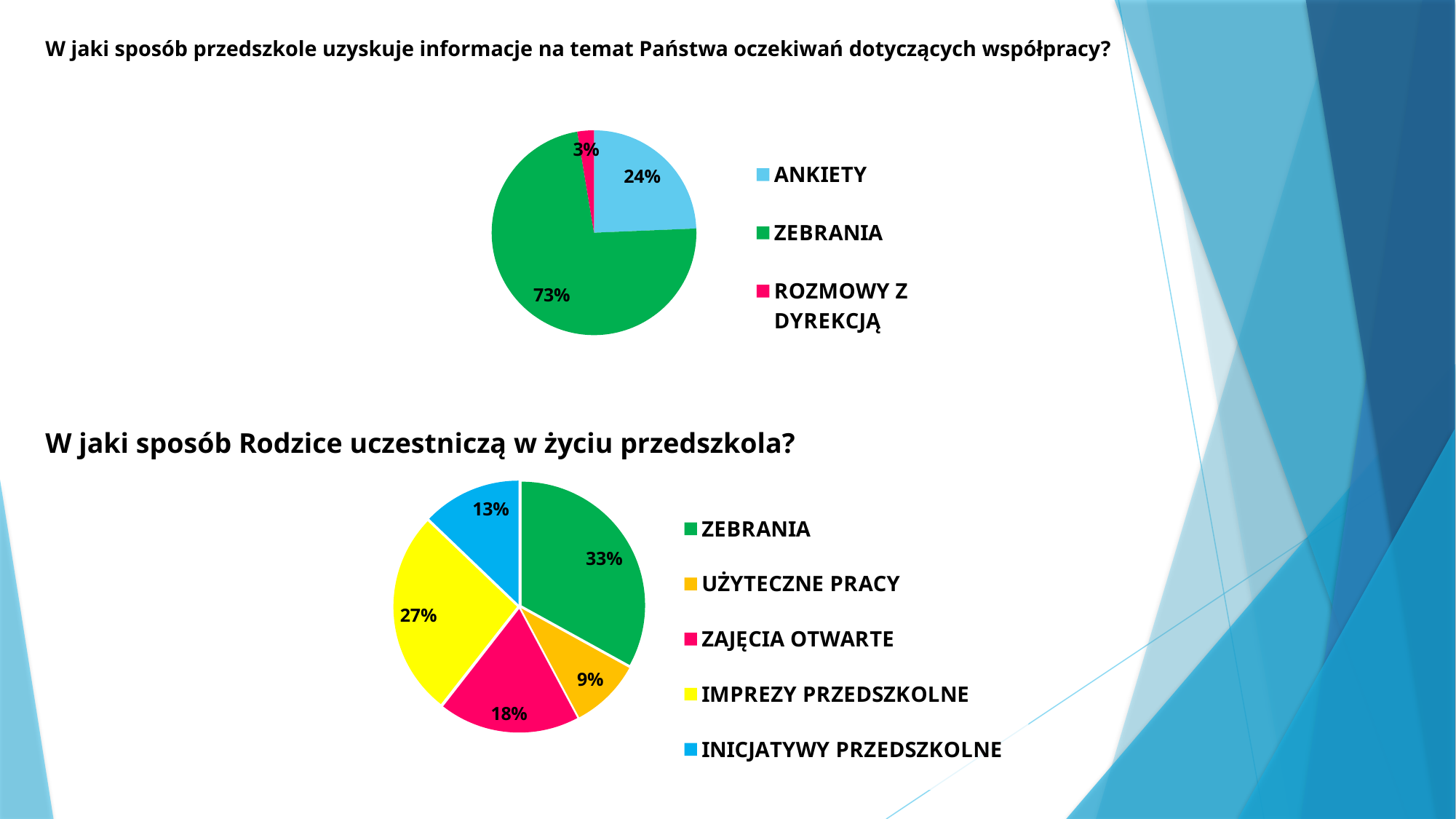
In the bottom pie chart, what share is labelled for IMPREZY PRZEDSZKOLNE? 27% In the bottom pie chart, which category has the largest slice? ZEBRANIA What type of chart is the bottom chart? Pie chart In the top pie chart, what share is labelled for ROZMOWY Z DYREKCJĄ? 3% In the bottom pie chart, what share is labelled for UŻYTECZNE PRACY? 9% In the top pie chart, how many slices are there? 3 In the top pie chart, which category has the smallest slice? ROZMOWY Z DYREKCJĄ In the bottom pie chart, how many categories does the legend list? 5 In the bottom pie chart, which is larger: INICJATYWY PRZEDSZKOLNE or ZAJĘCIA OTWARTE? ZAJĘCIA OTWARTE In the top pie chart, what share is labelled for ANKIETY? 24% In the bottom pie chart, what is the difference between the ZEBRANIA and ZAJĘCIA OTWARTE shares? 15% In the top pie chart, what share is labelled for ZEBRANIA? 73%